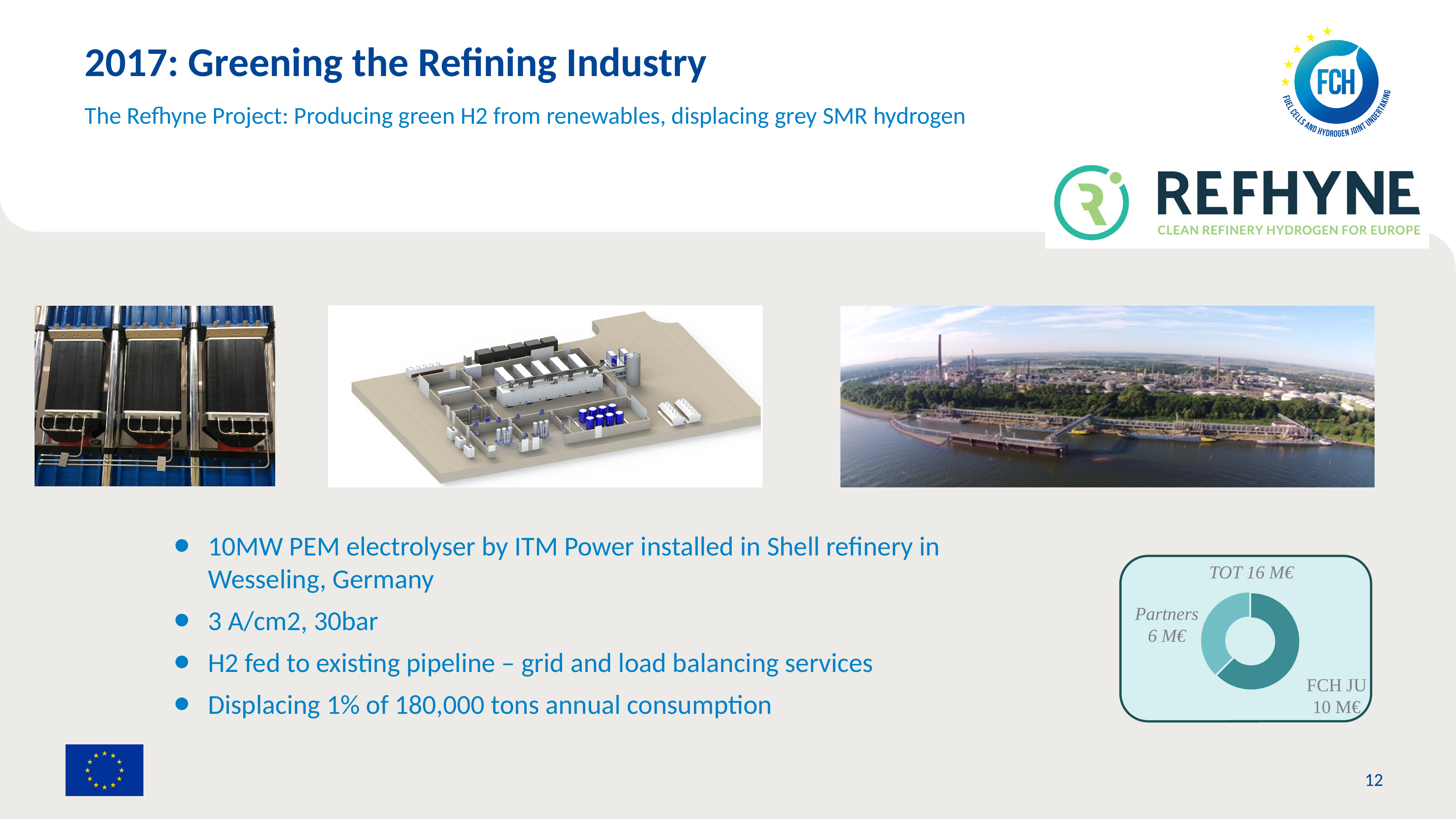
What kind of chart is shown in the box at the bottom right of the slide? doughnut chart In the funding chart, what share of the total does FCH JU represent? 62.5% In the funding chart, what is the value for Partners? 6 M€ In the funding chart, what is the value for FCH JU? 10 M€ What label appears above the funding chart? TOT 16 M€ What is the total shown for the funding chart? 16 M€ In the funding chart, what is the difference between the FCH JU and Partners contributions? 4 M€ In the funding chart, what share of the total do the Partners represent? 37.5% In the funding chart, which is larger: the FCH JU contribution or the Partners contribution? FCH JU How many segments does the funding chart have? 2 In the funding chart, which segment is the smallest? Partners In the funding chart, which segment is the largest? FCH JU